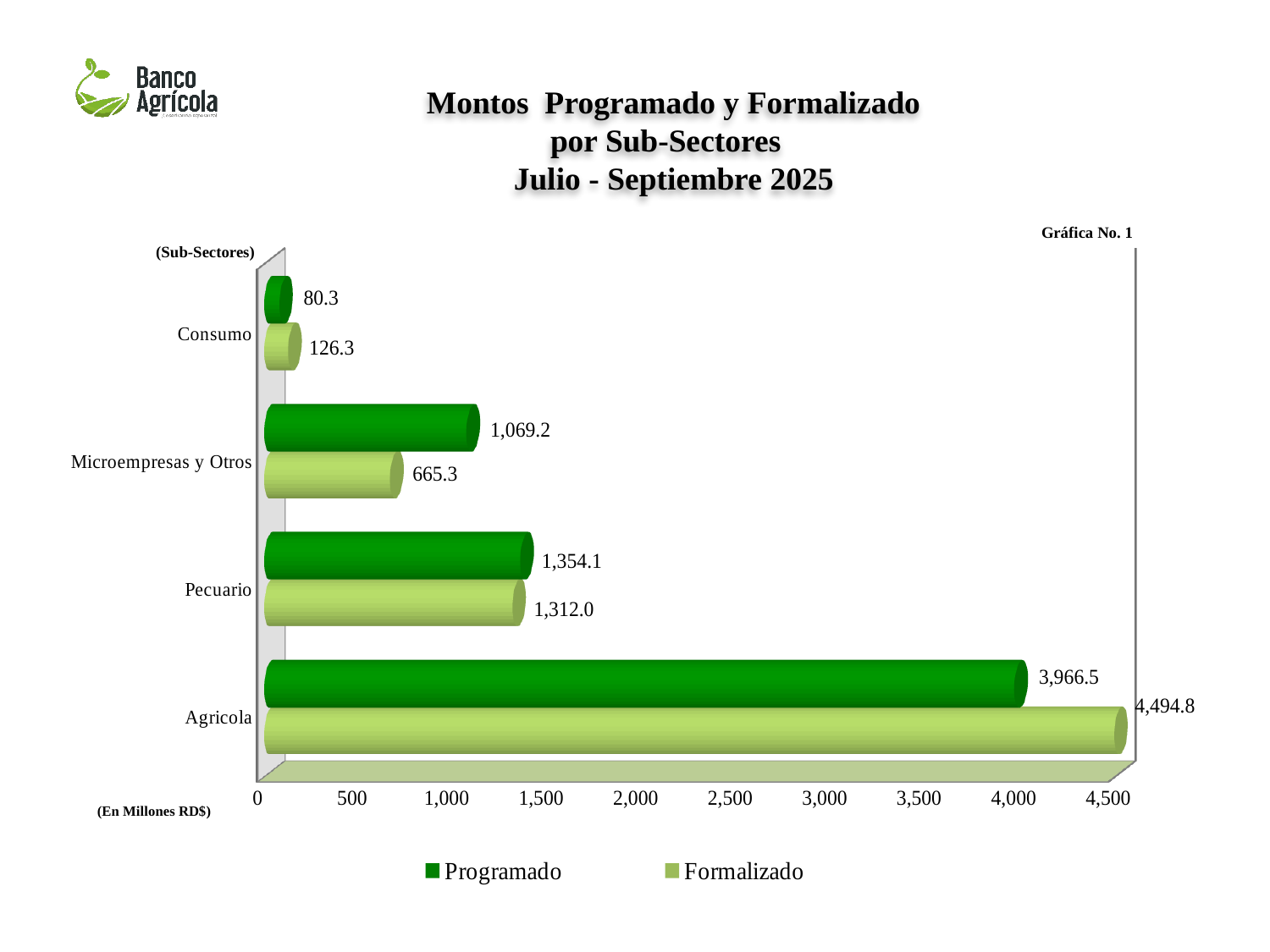
For Consumo, which is larger: the Programado value or the Formalizado value? Formalizado What is the difference between the Formalizado and Programado values for Agricola? 528.3 Which sub-sector has the lowest Programado value? Consumo How many series does the legend list? 2 What is the Programado value for Pecuario? 1,354.1 What is the Programado value for Agricola? 3,966.5 How many sub-sectors are shown on the chart? 4 What kind of chart is shown on the slide? Bar chart What is the difference between the Programado and Formalizado values for Microempresas y Otros? 403.9 What is the Formalizado value for Consumo? 126.3 What is the Formalizado value for Microempresas y Otros? 665.3 Which sub-sector has the highest Formalizado value? Agricola